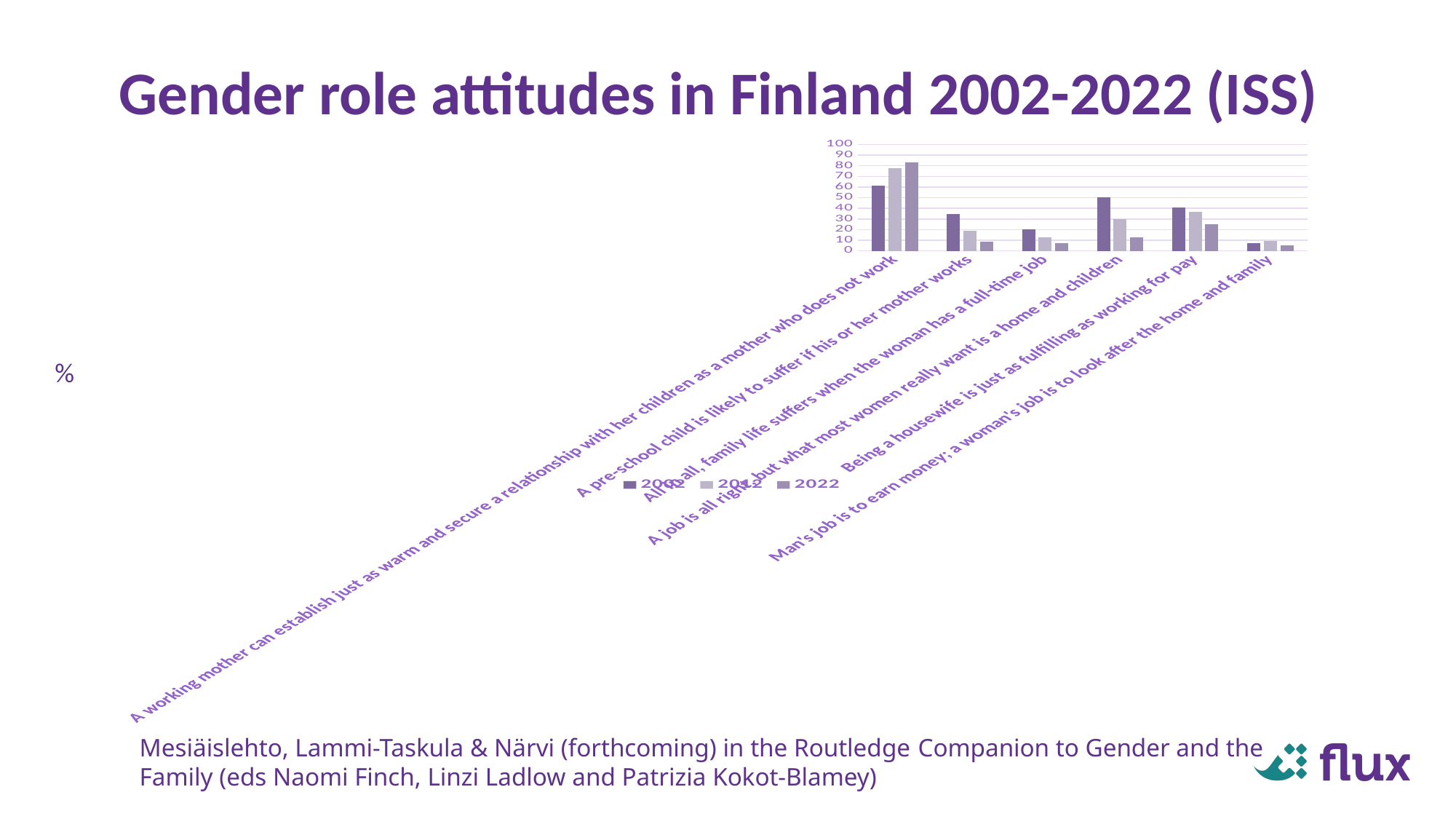
What kind of chart is shown on the slide? bar chart Is the 2022 value for 'A working mother can establish just as warm and secure a relationship with her children as a mother who does not work' greater or less than 70? greater Is the 2022 value for 'A pre-school child is likely to suffer if his or her mother works' greater or less than 20? less How many series does the legend list? 3 How many statement categories are plotted on the x axis? 6 For 'A working mother can establish just as warm and secure a relationship with her children as a mother who does not work', do the values rise or fall from 2002 to 2022? rise Which is larger for 'Being a housewife is just as fulfilling as working for pay': the 2002 value or the 2022 value? 2002 Which years are listed in the legend? 2002, 2012, 2022 Is the 2002 value for 'A job is all right, but what most women really want is a home and children' greater or less than 40? greater Which statement has the highest bar in the chart? A working mother can establish just as warm and secure a relationship with her children as a mother who does not work Which statement has the lowest 2022 bar? Man's job is to earn money; a woman's job is to look after the home and family For 'A pre-school child is likely to suffer if his or her mother works', do the values rise or fall from 2002 to 2022? fall